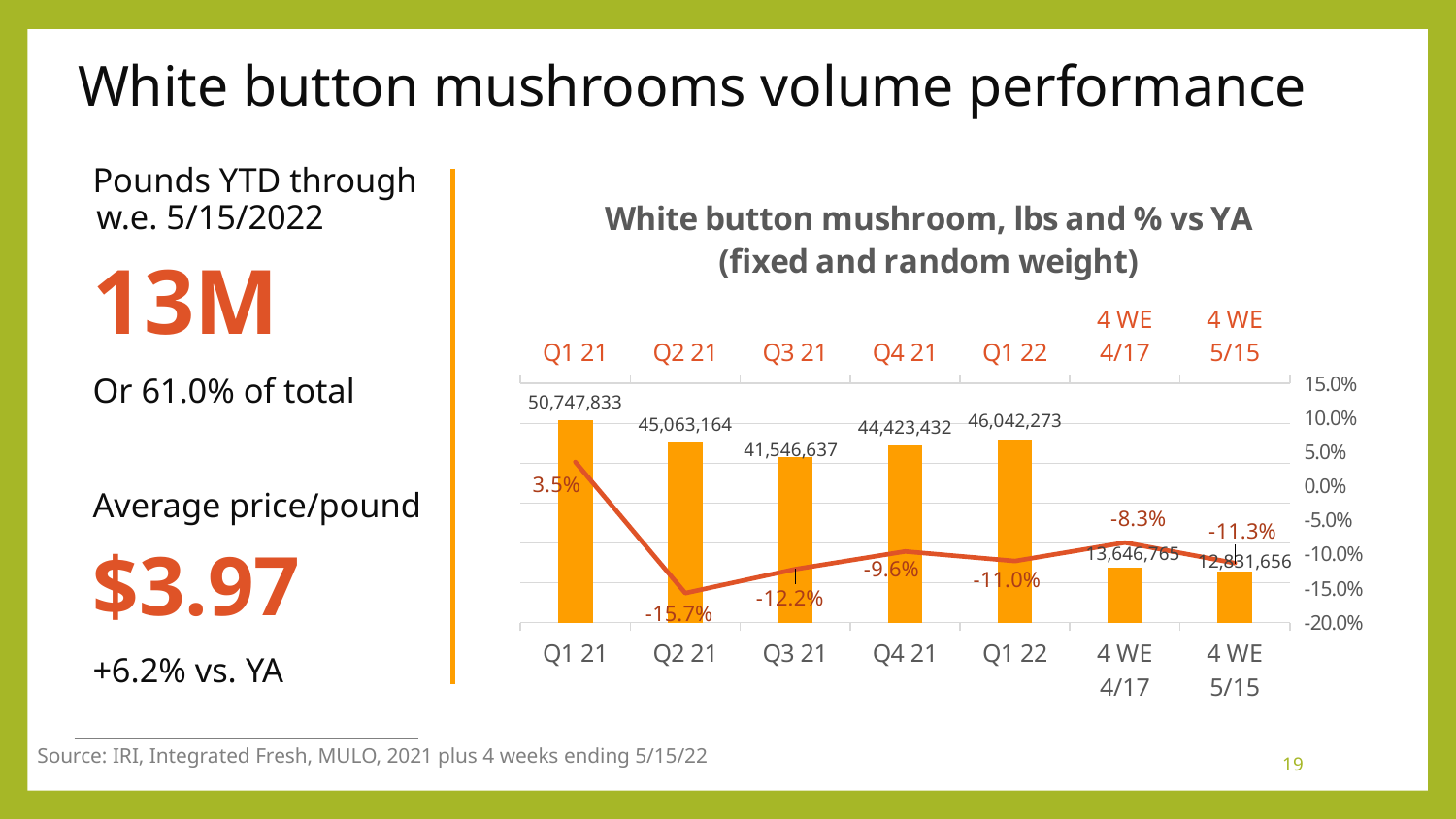
What is the pounds value for Q1 21? 50,747,833 What is the pounds value for Q3 21? 41,546,637 Which period is the only one with a positive % vs YA value? Q1 21 Which period has the lowest % vs YA value? Q2 21 What is the difference in pounds between Q1 21 and Q2 21? 5,684,669 What is the title of the chart? White button mushroom, lbs and % vs YA (fixed and random weight) Which period has the highest pounds value? Q1 21 Which has the higher pounds value, Q4 21 or Q1 22? Q1 22 How many periods are shown on the x axis? 7 What is the % vs YA value for Q2 21? -15.7% What kind of chart is this? Combined bar and line chart What is the % vs YA value for the 4 WE 4/17 period? -8.3%